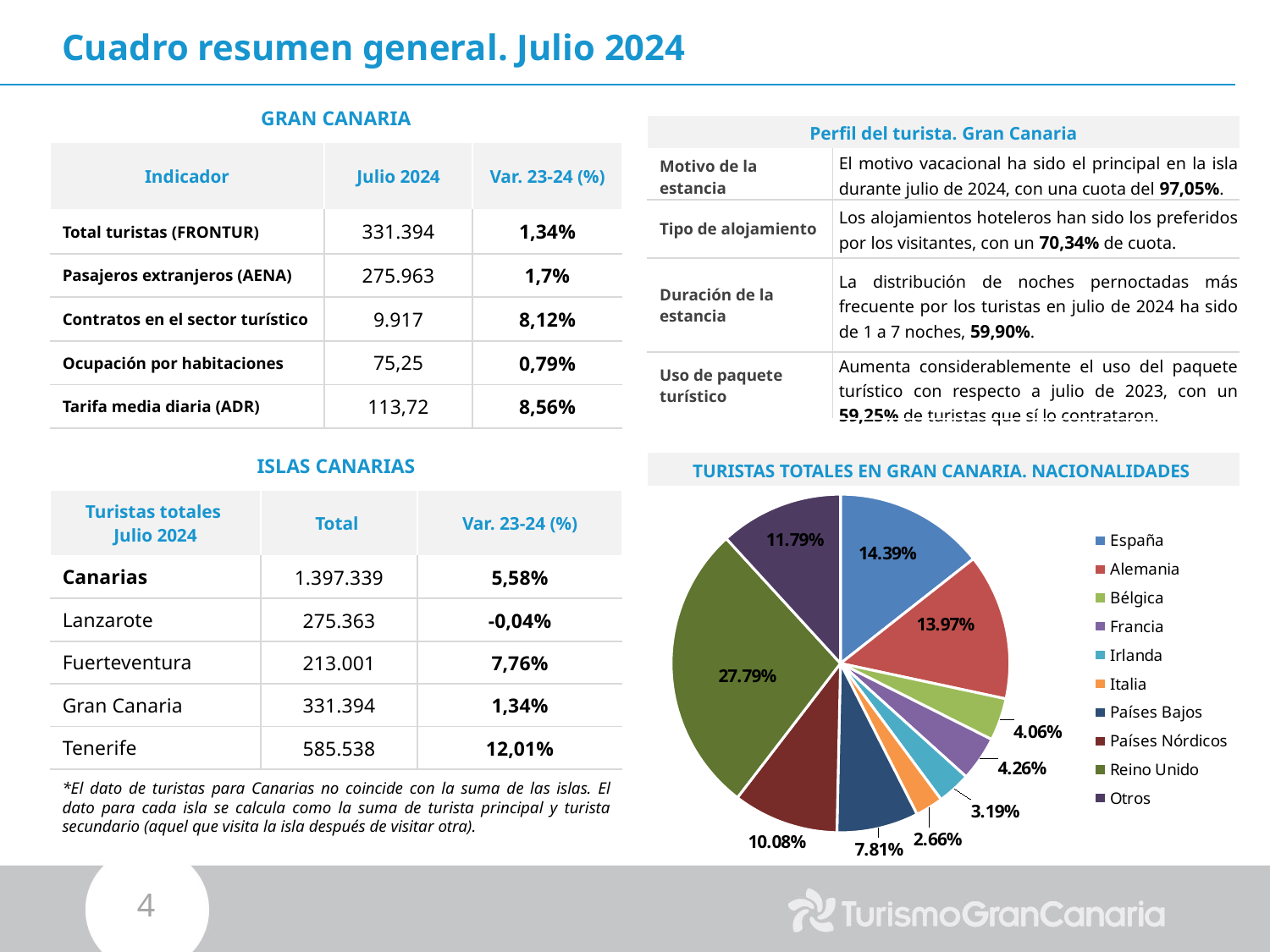
What type of chart is shown on the slide? pie chart Which slice is larger in the pie chart, España or Alemania? España What share of the pie chart does España represent? 14.39% What share of the pie chart does the Otros slice represent? 11.79% What is the title of the chart on the slide? TURISTAS TOTALES EN GRAN CANARIA. NACIONALIDADES How many nationality categories does the pie chart legend list? 10 What share of the pie chart does Italia represent? 2.66% What is the difference in percentage points between the Reino Unido slice and the España slice? 13.40 Which nationality has the smallest slice in the pie chart? Italia What share of the pie chart does Países Nórdicos represent? 10.08% Which nationality has the largest slice in the pie chart? Reino Unido What share of the pie chart does Reino Unido represent? 27.79%